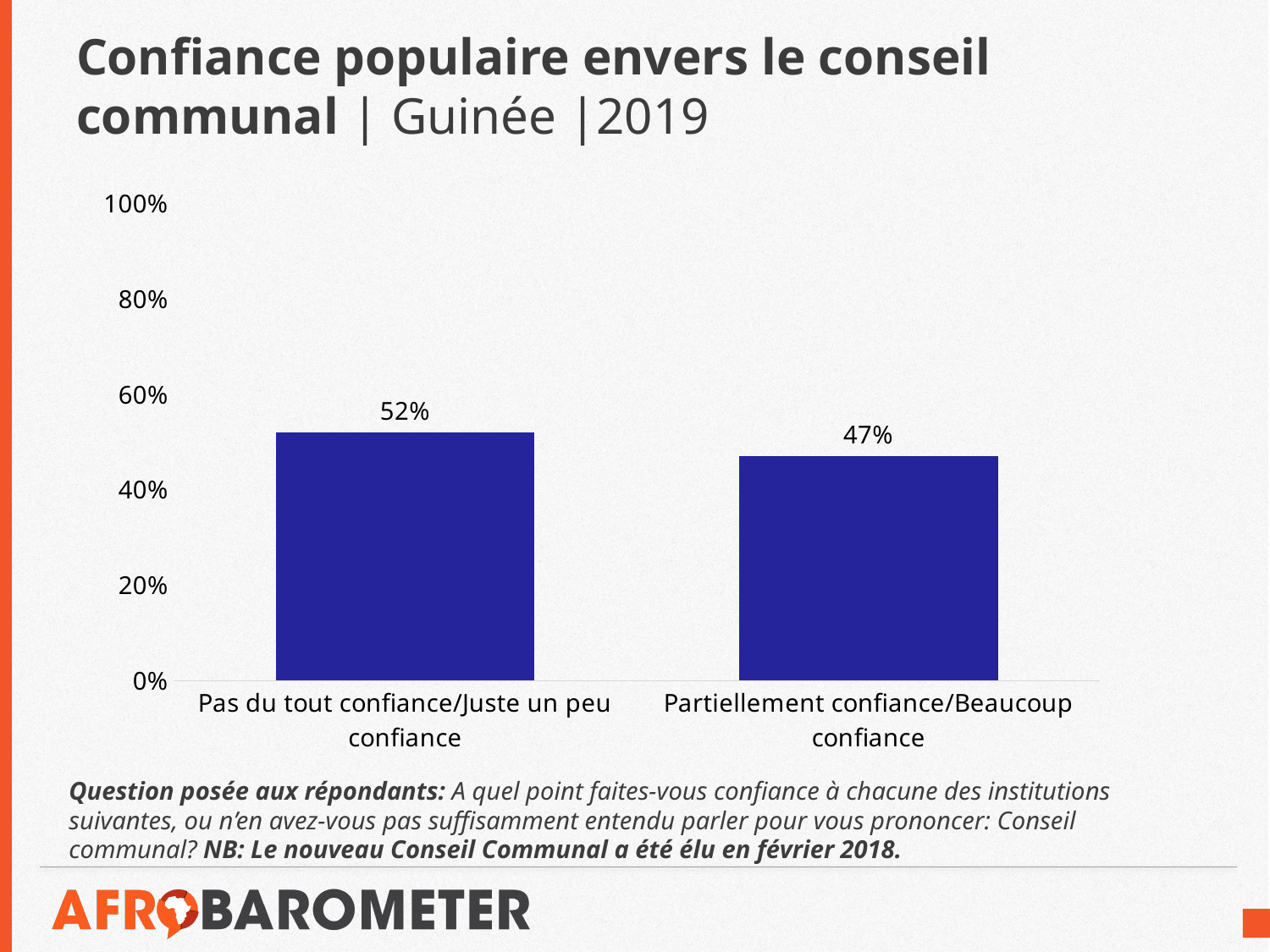
What kind of chart is shown on the slide? bar chart What is the difference between the values for "Pas du tout confiance/Juste un peu confiance" and "Partiellement confiance/Beaucoup confiance"? 5% What is the highest value shown on the vertical axis? 100% Which category has the highest value? Pas du tout confiance/Juste un peu confiance Is the value for "Pas du tout confiance/Juste un peu confiance" greater or less than 40%? greater Which category has the lowest value? Partiellement confiance/Beaucoup confiance What is the value for "Partiellement confiance/Beaucoup confiance"? 47% Which is larger: the value for "Pas du tout confiance/Juste un peu confiance" or for "Partiellement confiance/Beaucoup confiance"? Pas du tout confiance/Juste un peu confiance How many categories are shown in the chart? 2 Is the value for "Partiellement confiance/Beaucoup confiance" greater or less than 60%? less What is the value for "Pas du tout confiance/Juste un peu confiance"? 52% What is the title of the chart? Confiance populaire envers le conseil communal | Guinée | 2019